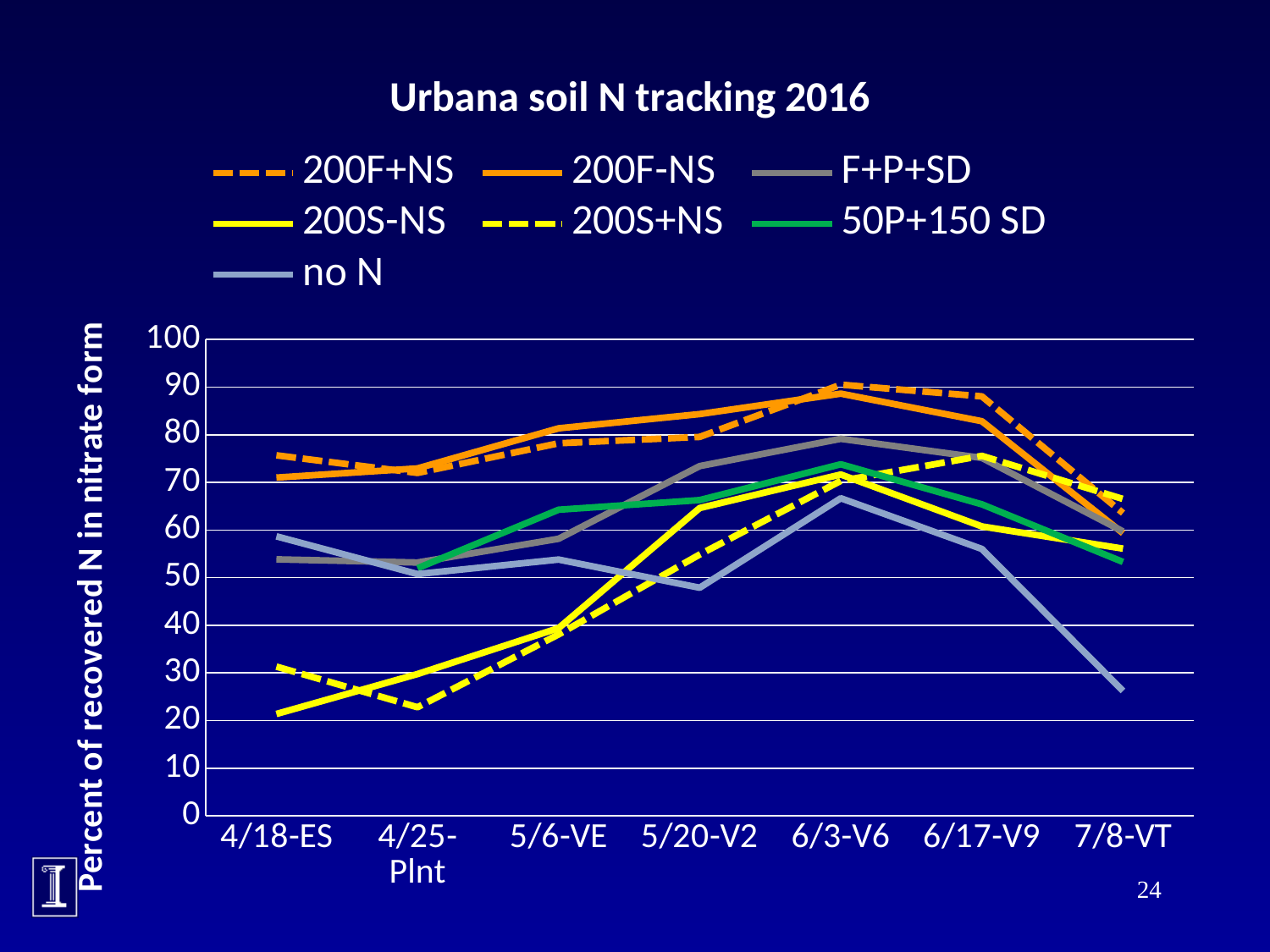
What is the title of the chart? Urbana soil N tracking 2016 What is the label on the vertical axis? Percent of recovered N in nitrate form Which series has the lowest value at 7/8-VT? no N Is the value for 200S-NS at 4/18-ES greater or less than 30? less How many sampling dates are shown along the x axis? 7 Is the value for 200F-NS at 6/3-V6 greater or less than 80? greater Is the value for F+P+SD at 6/3-V6 greater or less than 70? greater Which series has the lowest value at 4/18-ES? 200S-NS How many series does the legend list? 7 What kind of chart is shown on the slide? line chart At 5/20-V2, which is larger: the value for 200F-NS or the value for no N? 200F-NS